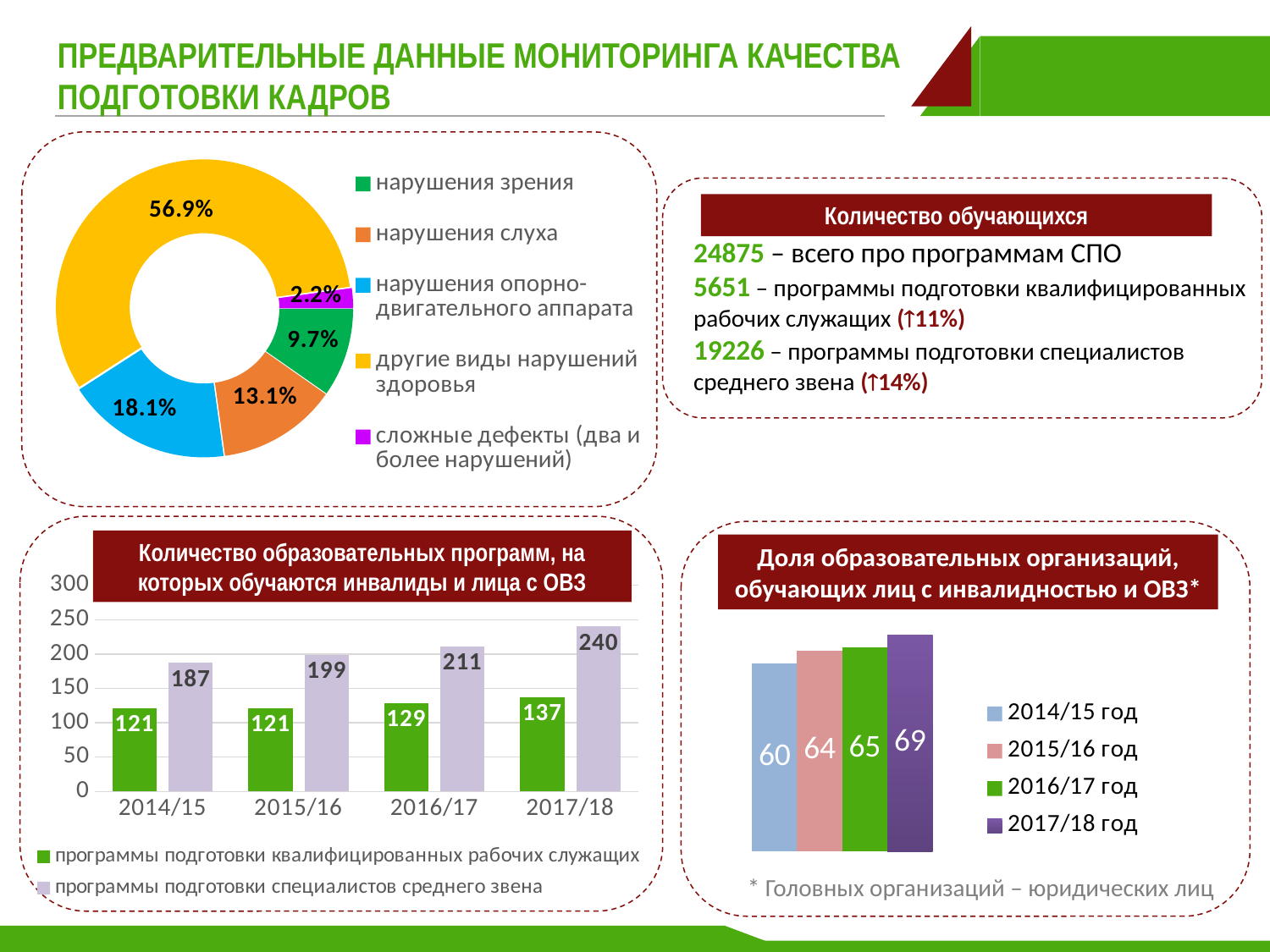
How many series does the legend of the chart 'Количество образовательных программ, на которых обучаются инвалиды и лица с ОВЗ' list? 2 In the chart 'Количество образовательных программ, на которых обучаются инвалиды и лица с ОВЗ', what is the value for 'программы подготовки квалифицированных рабочих служащих' in 2016/17? 129 What kind of chart is 'Доля образовательных организаций, обучающих лиц с инвалидностью и ОВЗ*'? bar chart How many categories does the legend of the doughnut chart at the top left list? 5 In the chart 'Количество образовательных программ, на которых обучаются инвалиды и лица с ОВЗ', do the values for 'программы подготовки специалистов среднего звена' rise or fall from 2014/15 to 2017/18? rise In the chart 'Доля образовательных организаций, обучающих лиц с инвалидностью и ОВЗ*', which year has the highest value? 2017/18 год In the chart 'Количество образовательных программ, на которых обучаются инвалиды и лица с ОВЗ', what is the difference between the two series in 2014/15? 66 In the chart 'Количество образовательных программ, на которых обучаются инвалиды и лица с ОВЗ', what is the value for 'программы подготовки специалистов среднего звена' in 2017/18? 240 In the doughnut chart at the top left, what percentage is shown for 'нарушения опорно-двигательного аппарата'? 18.1% In the doughnut chart at the top left, what share is labelled for 'другие виды нарушений здоровья'? 56.9% In the doughnut chart at the top left, which category has the smallest share? сложные дефекты (два и более нарушений) In the chart 'Доля образовательных организаций, обучающих лиц с инвалидностью и ОВЗ*', what is the value for 2015/16 год? 64